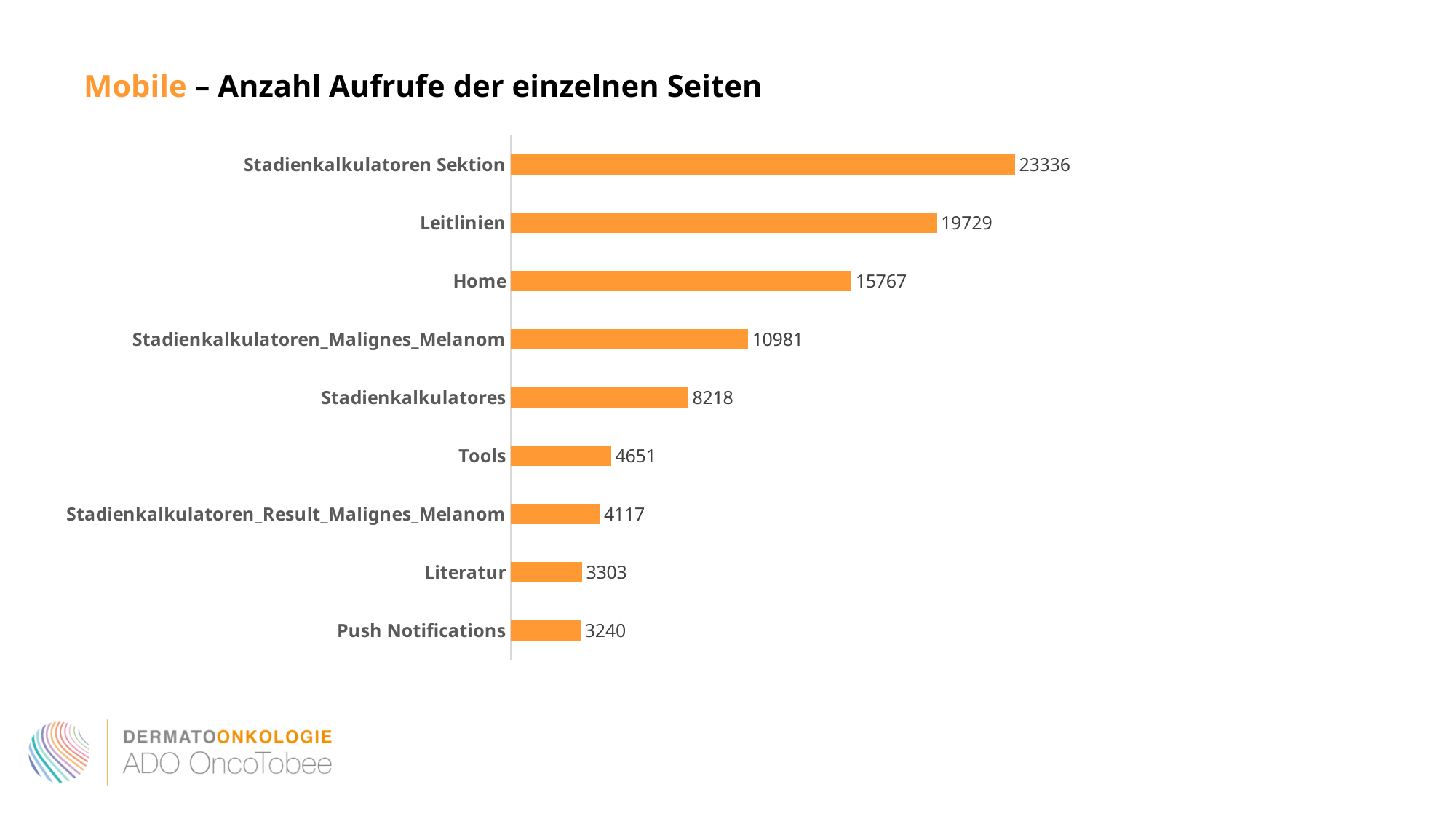
What is the value for Push Notifications? 3240 What kind of chart is shown on the slide? Bar chart How many categories are shown in the chart? 9 What is the difference between the values for Tools and Literatur? 1348 What is the value for Home? 15767 What is the value for Stadienkalkulatoren_Result_Malignes_Melanom? 4117 Which category has the highest value? Stadienkalkulatoren Sektion Which has a larger value, Stadienkalkulatores or Stadienkalkulatoren_Malignes_Melanom? Stadienkalkulatoren_Malignes_Melanom What is the difference between the values for Stadienkalkulatoren Sektion and Leitlinien? 3607 What is the value for Leitlinien? 19729 Which category has the lowest value? Push Notifications What is the title of the slide? Mobile – Anzahl Aufrufe der einzelnen Seiten